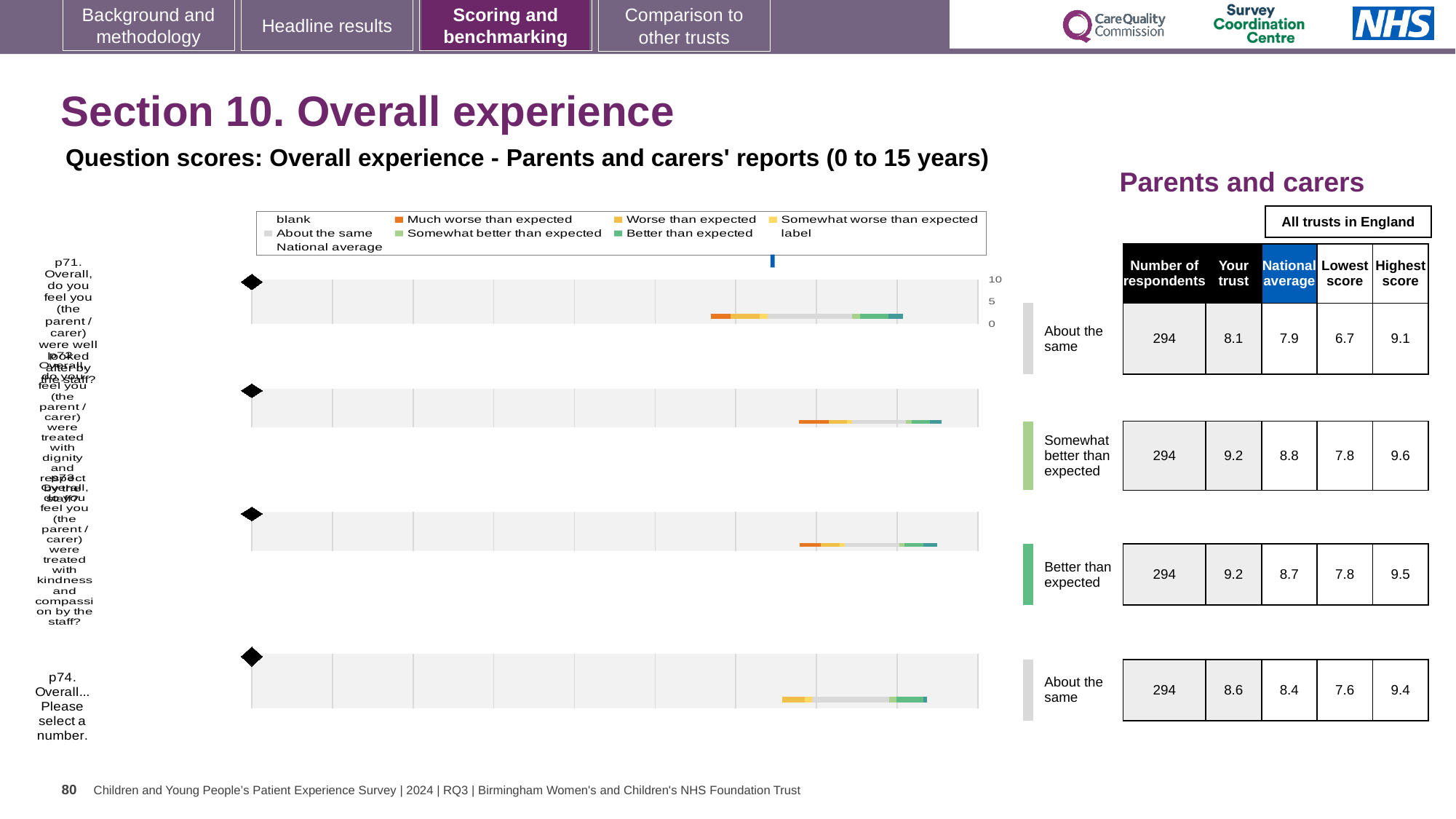
What is the number of respondents shown for p71? 294 Which question has the lowest 'Your trust' score? p71 What is the highest score shown for the second question row (Somewhat better than expected)? 9.6 What is the national average score for p74 (Overall... Please select a number)? 8.4 What kind of chart is used to show the question scores on this slide? Bar chart What benchmark category is shown for p74? About the same How many entries does the legend of the question scores chart list? 9 For p74, which is larger: the 'Your trust' score or the national average? Your trust (8.6) What is the 'Your trust' score for p71 (Overall, do you feel you were well looked after by the staff?)? 8.1 What is the difference between the 'Your trust' score and the national average for p71? 0.2 What is the difference between the highest score and the lowest score for p71? 2.4 How many questions (rows) are plotted in the question scores chart? 4